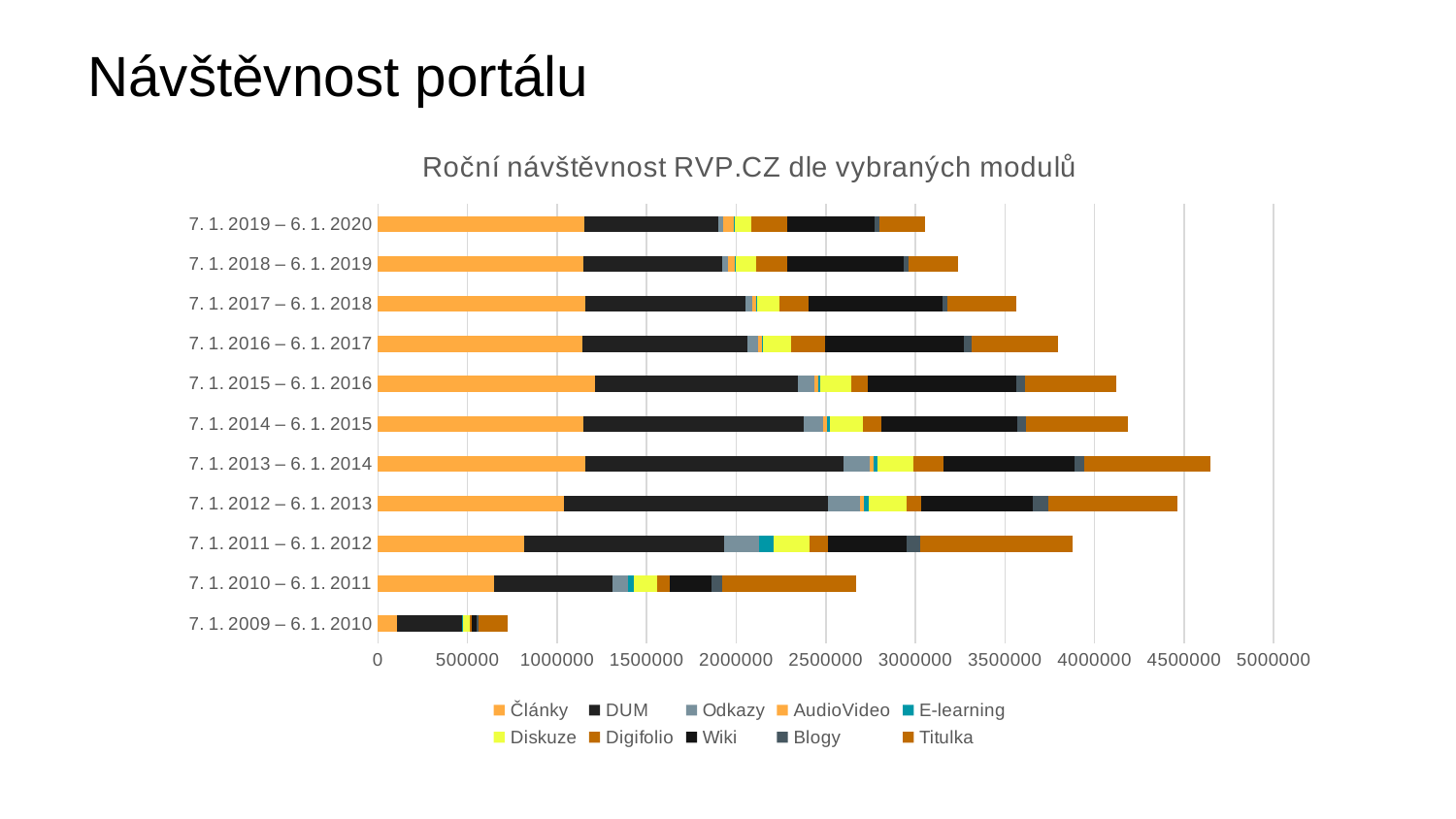
From the period 7. 1. 2013 – 6. 1. 2014 to 7. 1. 2019 – 6. 1. 2020, do the total bars rise or fall? fall Is the total bar for 7. 1. 2009 – 6. 1. 2010 greater or less than 1000000? less Is the total bar for 7. 1. 2011 – 6. 1. 2012 greater or less than 3500000? greater How many series does the legend list? 10 What kind of chart is shown on the slide? Stacked bar chart How many yearly periods (categories) are plotted in the chart? 11 Which period has the longest total bar? 7. 1. 2013 – 6. 1. 2014 Which period has a larger total bar: 7. 1. 2010 – 6. 1. 2011 or 7. 1. 2018 – 6. 1. 2019? 7. 1. 2018 – 6. 1. 2019 Is the total bar for 7. 1. 2019 – 6. 1. 2020 greater or less than 3500000? less What is the title of the chart? Roční návštěvnost RVP.CZ dle vybraných modulů Which period has the shortest total bar? 7. 1. 2009 – 6. 1. 2010